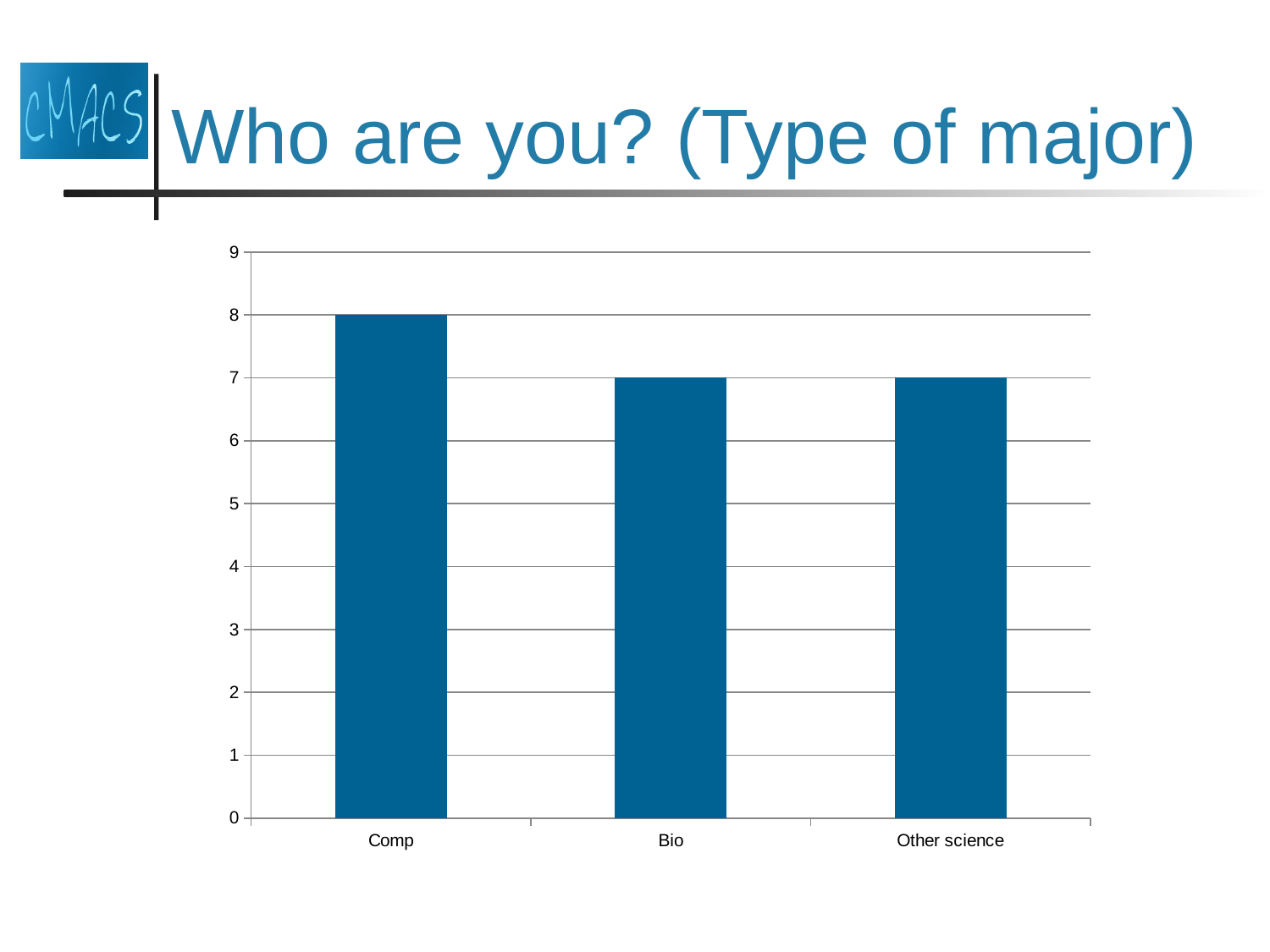
What is the title of the slide containing the chart? Who are you? (Type of major) What is the value for Other science? 7 Which is larger, the value for Comp or the value for Other science? Comp Is the value for Bio greater or less than 5? greater Is the value for Comp greater or less than 6? greater What is the value for Bio? 7 What is the value for Comp? 8 Which category has the highest value? Comp Do the values for Bio and Other science differ? No, both are 7 What kind of chart is shown on the slide? bar chart How many categories are shown on the x axis? 3 What is the difference between the values for Comp and Bio? 1